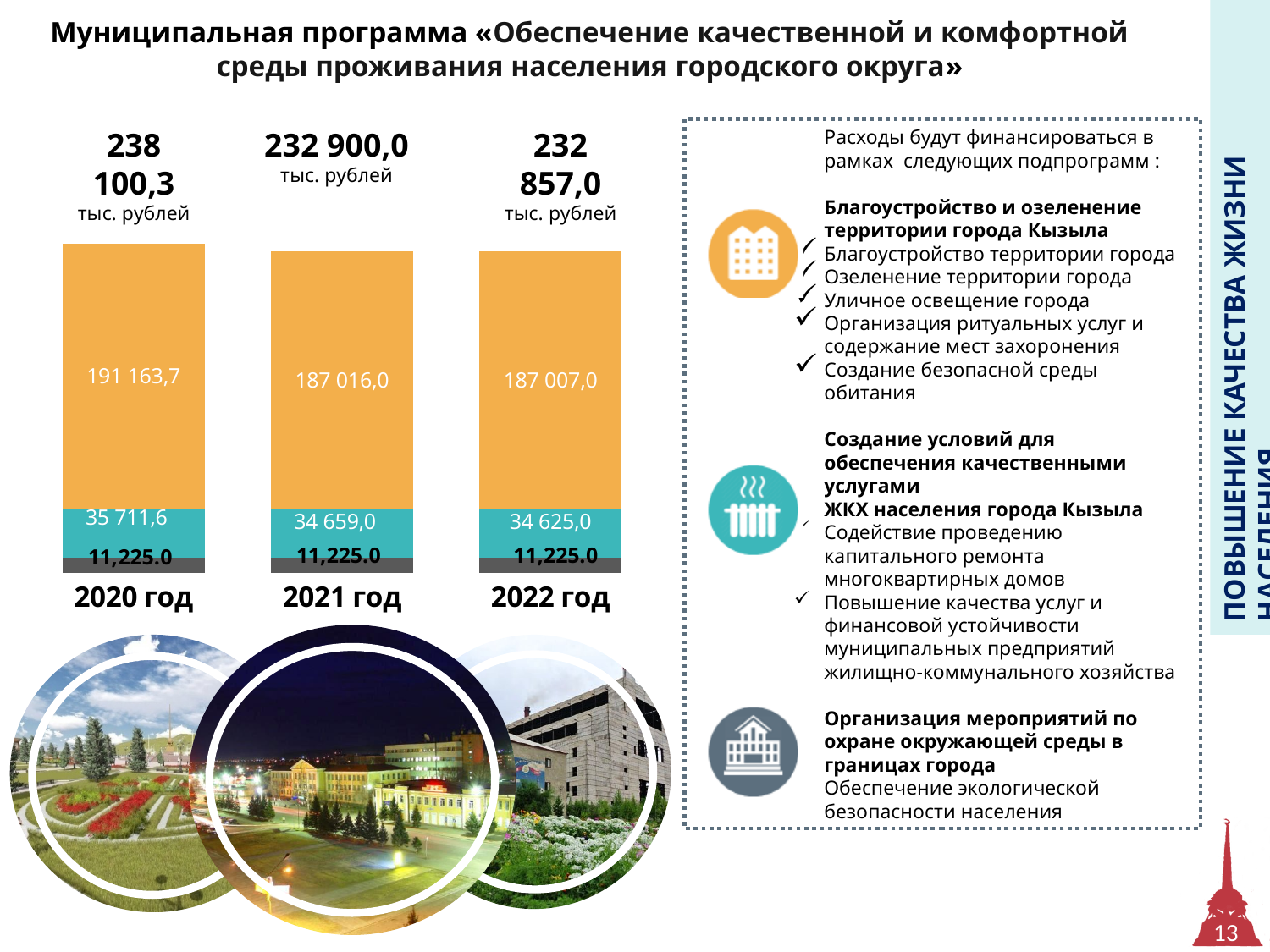
What is the difference between the totals for 2021 год and 2022 год? 43,0 Which year has the lowest value for the orange segment? 2022 год What kind of chart is shown on the slide? Stacked bar chart What total is printed above the bar for 2020 год? 238 100,3 тыс. рублей What is the value of the teal segment for 2022 год? 34 625,0 Which is larger, the teal segment for 2020 год or for 2021 год? 2020 год Which year has the highest total? 2020 год What is the value of the dark grey bottom segment for 2021 год? 11,225.0 How many years are shown on the chart? 3 What total is printed above the bar for 2021 год? 232 900,0 тыс. рублей What is the value of the orange segment for 2020 год? 191 163,7 What is the difference between the orange segment values for 2020 год and 2021 год? 4 147,7